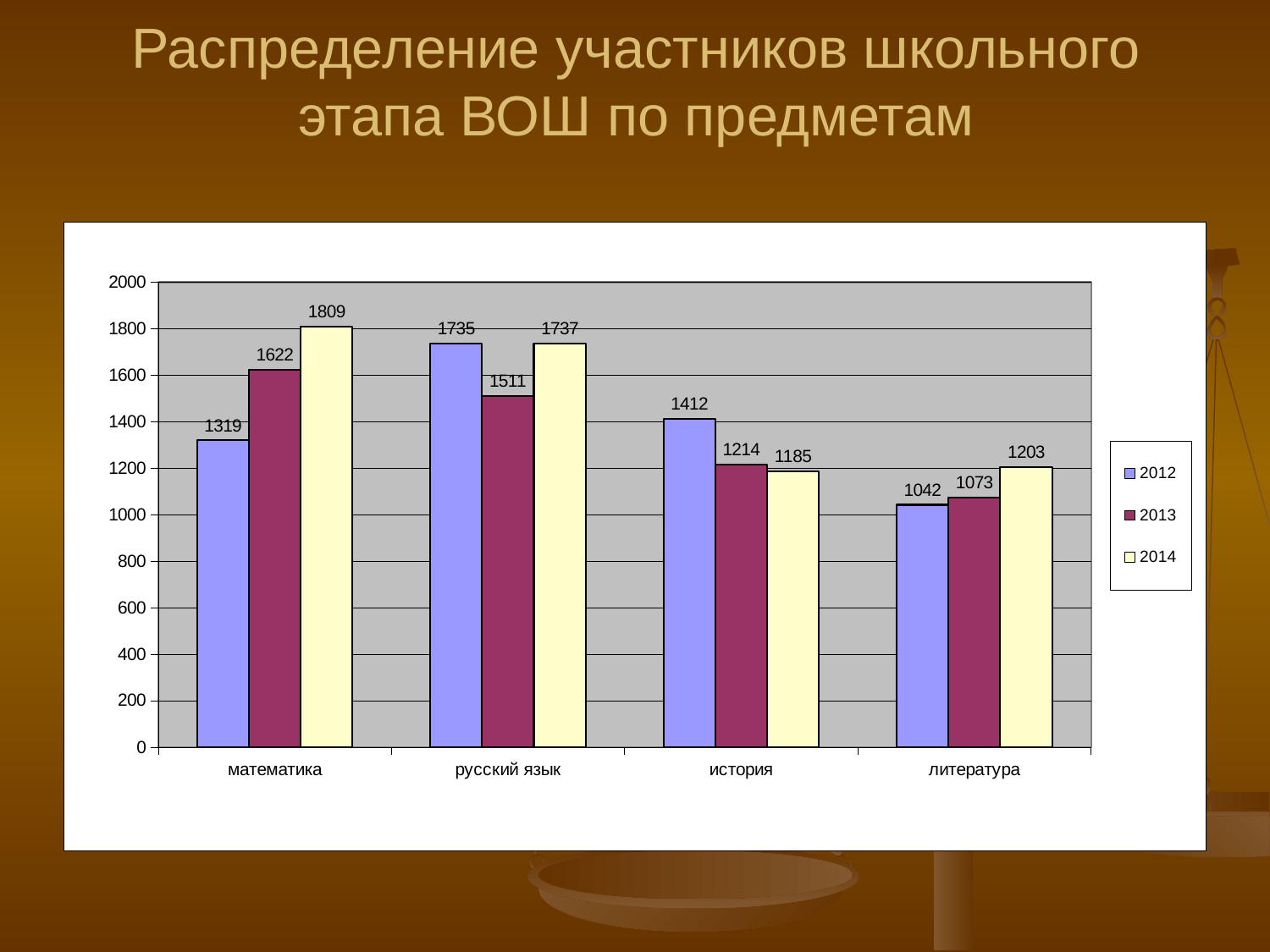
How many series does the legend list? 3 What is the value for история in 2012? 1412 How many subjects are shown on the x axis? 4 What is the difference between the 2014 and 2012 values for математика? 490 What is the value for литература in 2013? 1073 What is the value for математика in 2014? 1809 What kind of chart is shown on the slide? bar chart Which is larger for русский язык: the 2012 value or the 2013 value? 2012 Which subject has the highest value in 2012? русский язык Which subject has the lowest value in 2014? история Do the values for математика rise or fall from 2012 to 2014? rise Is the value for история in 2013 greater or less than 1400? less